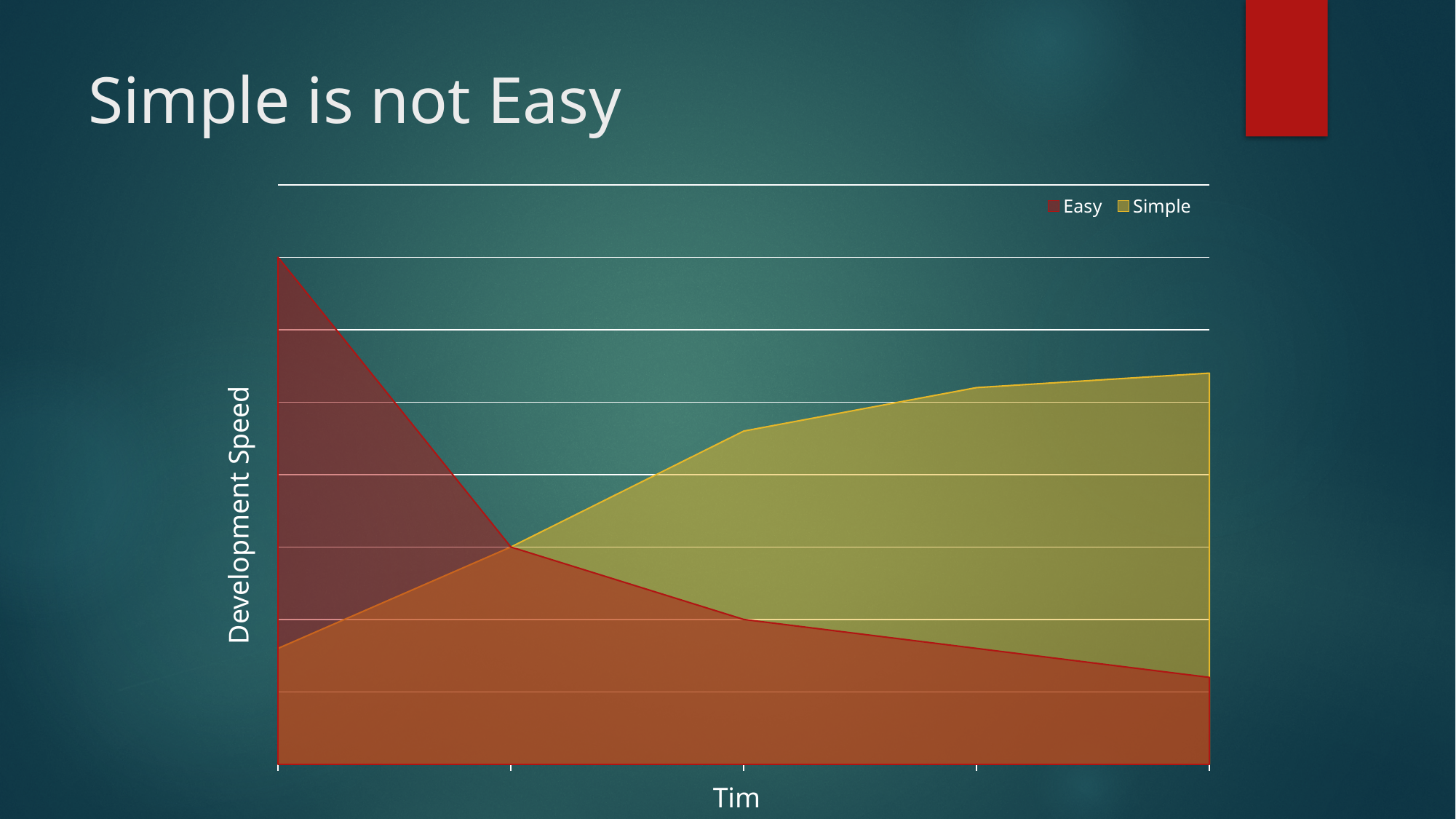
How many data points does each series have along the x axis? 5 At the right end of the chart, which series has the higher value, Easy or Simple? Simple What kind of chart is shown on the slide? Area chart At the left end of the chart, which series has the higher value, Easy or Simple? Easy Which series reaches the highest point anywhere on the chart? Easy Does the Simple series rise or fall along the x axis? Rise Which series are listed in the chart's legend? Easy and Simple Does the Easy series rise or fall along the x axis? Fall Which series has the lowest value at the right end of the chart? Easy How many series does the chart's legend list? 2 What is the label on the chart's vertical axis? Development Speed